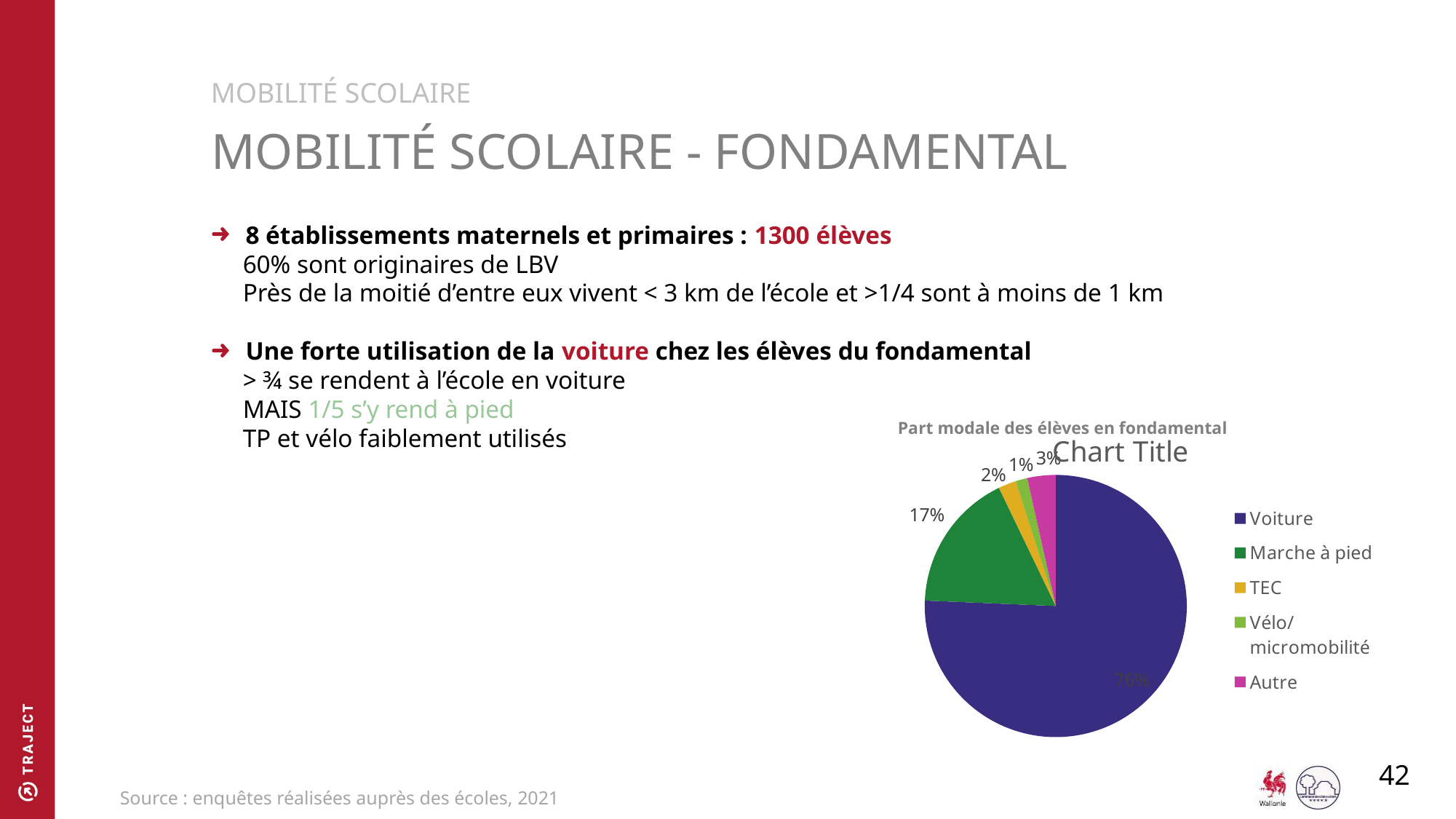
What share of the pie does Vélo/micromobilité represent? 1% How many categories does the legend of the pie chart list? 5 What colour is the Marche à pied slice in the pie chart? green Which is larger, the share for Autre or the share for TEC? Autre What share of the pie does Autre represent? 3% What share of the pie does TEC represent? 2% What is the difference in percentage points between Voiture and Marche à pied? 59 What kind of chart is shown on the slide? pie chart What share of the pie does Marche à pied represent? 17% What share of the pie does Voiture represent? 76% Which category has the largest slice of the pie? Voiture Which category has the smallest slice of the pie? Vélo/micromobilité